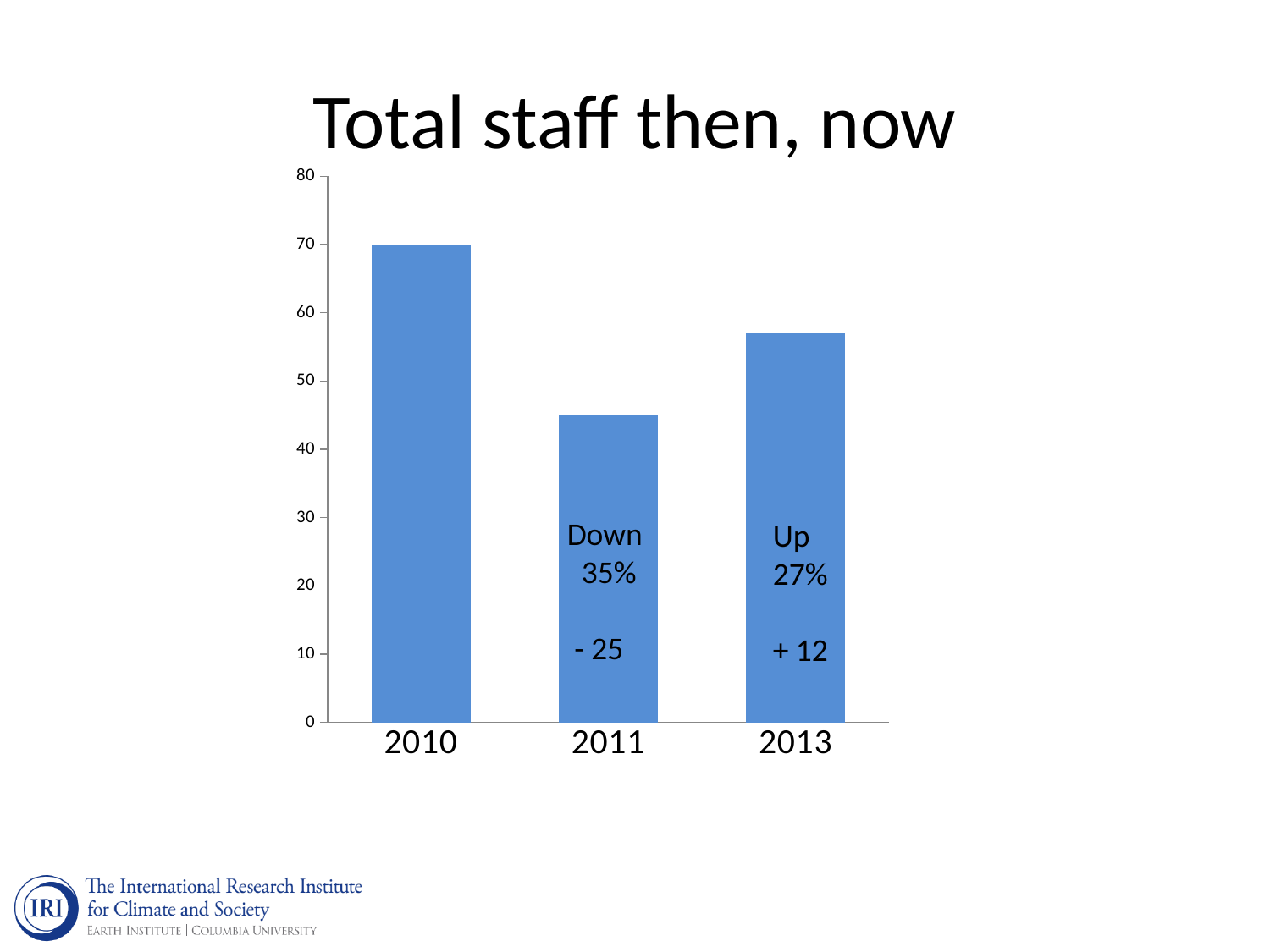
What kind of chart is shown on the slide? bar chart Is the value for 2011 greater or less than 50? less Which is larger, the value for 2010 or the value for 2013? 2010 What is the total staff value for 2010? 70 How many years are shown on the x axis of the chart? 3 What percentage change is written on the 2011 bar? Down 35% Is the value for 2013 greater or less than 50? greater Which year has the lowest total staff? 2011 What staff change is written on the 2013 bar? + 12 Do the values fall or rise from 2010 to 2011? fall Which year has the highest total staff? 2010 What is the title of the chart? Total staff then, now